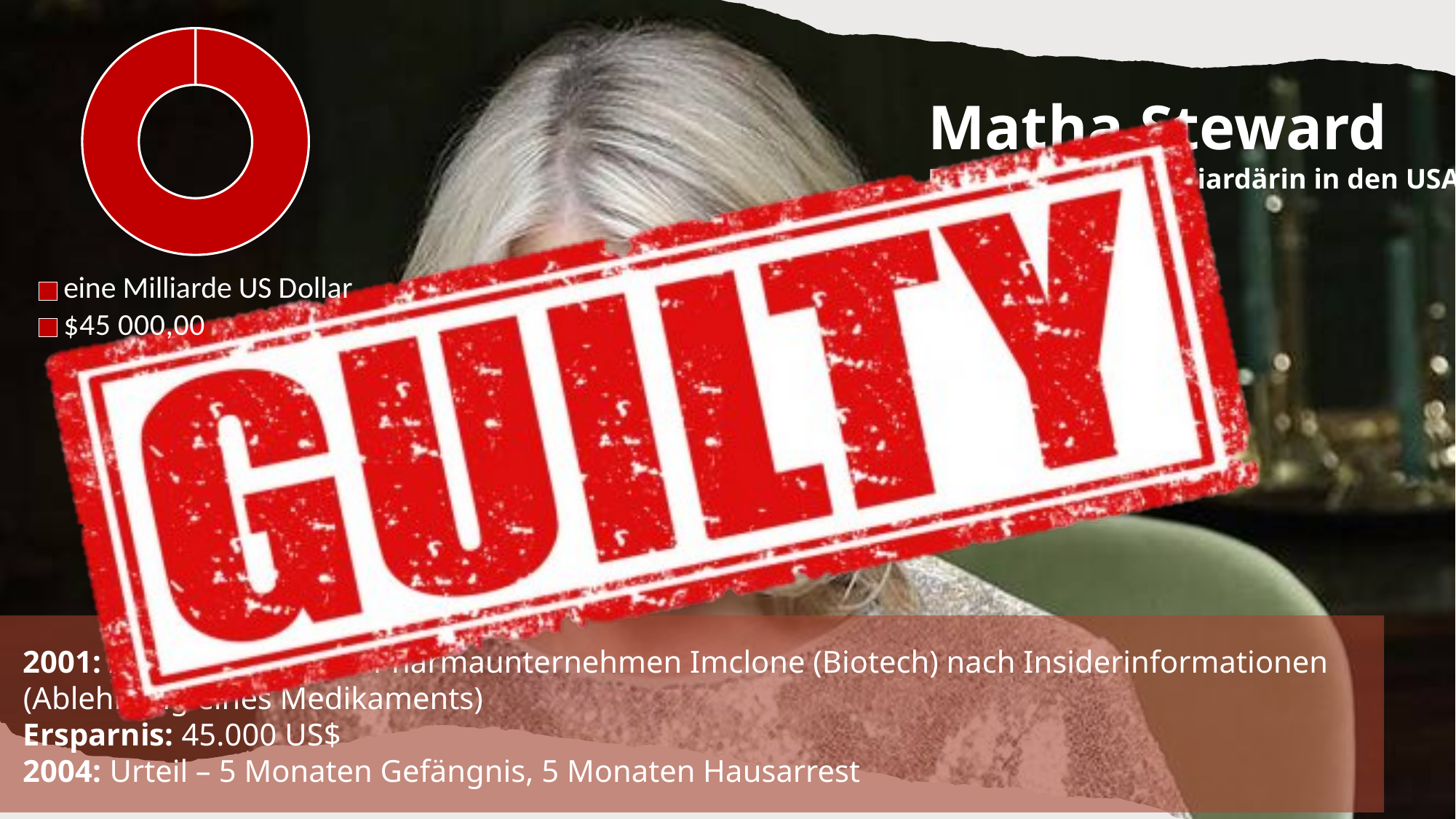
How many categories are shown in the doughnut chart? 2 What colour are the slices of the doughnut chart? red Which category takes up the smallest part of the doughnut chart? $45 000,00 What is the first entry listed in the legend of the doughnut chart? eine Milliarde US Dollar Which is larger in the doughnut chart, the slice for "eine Milliarde US Dollar" or the slice for "$45 000,00"? eine Milliarde US Dollar How many entries does the legend of the doughnut chart list? 2 What kind of chart is shown at the top left of the slide? doughnut chart Which category takes up the larger part of the doughnut chart? eine Milliarde US Dollar